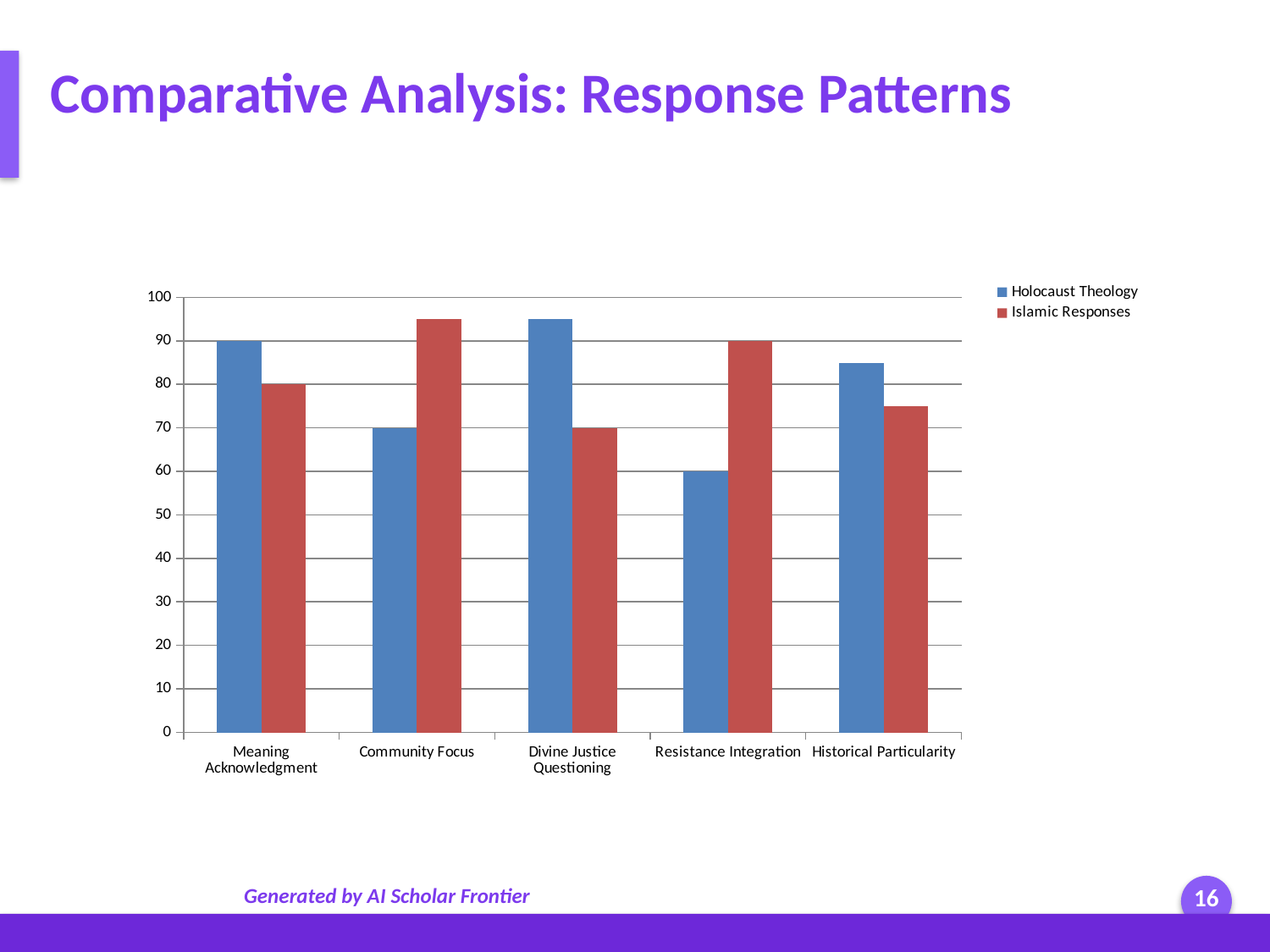
Is the Islamic Responses value for Historical Particularity greater or less than 80? less What is the difference between the Islamic Responses and Holocaust Theology values for Resistance Integration? 30 What is the Islamic Responses value for Divine Justice Questioning? 70 For Community Focus, which series has the larger value, Holocaust Theology or Islamic Responses? Islamic Responses What is the Holocaust Theology value for Meaning Acknowledgment? 90 What is the Holocaust Theology value for Resistance Integration? 60 Is the Holocaust Theology value for Divine Justice Questioning greater or less than 90? greater Which category has the highest Islamic Responses value? Community Focus How many series does the legend list? 2 What is the Islamic Responses value for Resistance Integration? 90 How many categories are shown on the x axis? 5 Which category has the lowest Holocaust Theology value? Resistance Integration